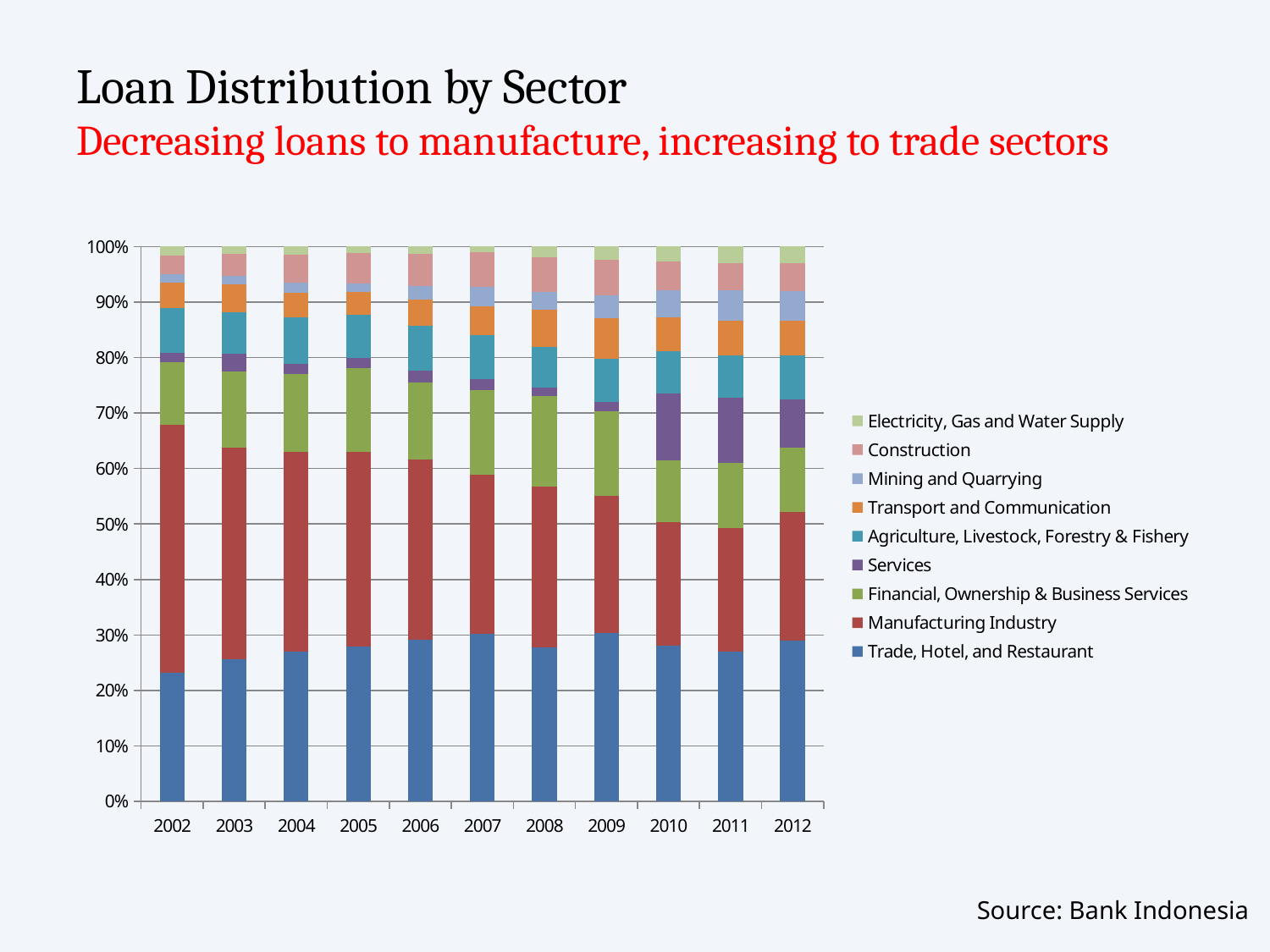
How many series does the chart's legend list? 9 Is the Services share in 2011 greater or less than 10%? greater How many years are shown along the x axis of the chart? 11 Which sector has the largest share of loans in 2002? Manufacturing Industry Is the Trade, Hotel, and Restaurant share in 2002 greater or less than 30%? less What is the title of the slide containing the chart? Loan Distribution by Sector What source is cited for the chart data? Bank Indonesia What does each stacked bar in the chart total? 100% Is the Trade, Hotel, and Restaurant share in 2009 greater or less than 20%? greater Does the Manufacturing Industry share rise or fall from 2002 to 2012? fall In 2002, which is larger: the Manufacturing Industry share or the Trade, Hotel, and Restaurant share? Manufacturing Industry What kind of chart is shown on the slide? Stacked bar chart